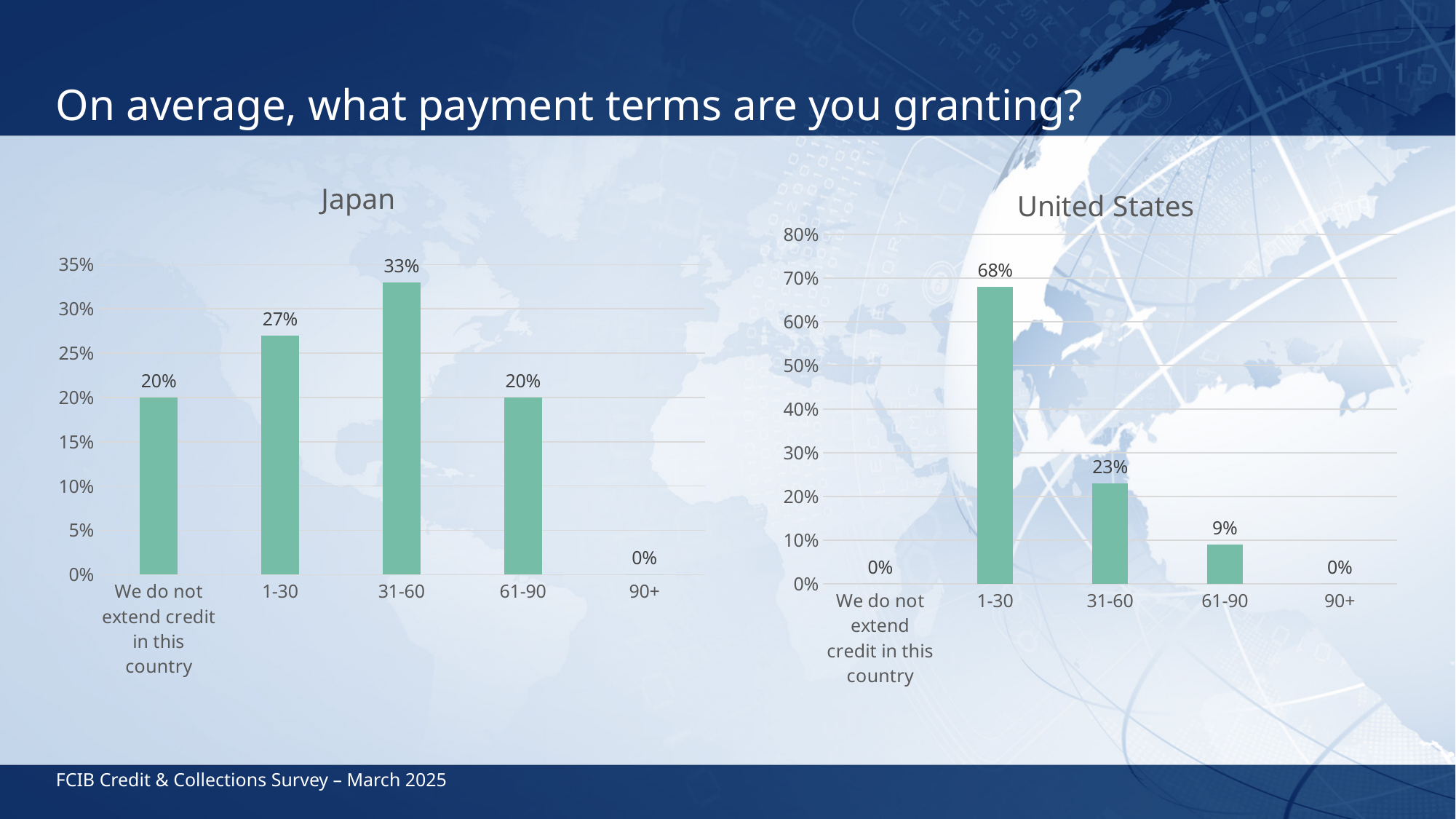
In the United States chart, what is the value for 'We do not extend credit in this country'? 0% In the Japan chart, which is larger, the value for 1-30 or the value for 61-90? 1-30 In the United States chart, what is the difference between the values for 1-30 and 31-60? 45% In the Japan chart, what is the value for 31-60? 33% How many categories are shown on the x axis of the United States chart? 5 In the United States chart, which category has the highest value? 1-30 In the United States chart, what is the value for 1-30? 68% In the Japan chart, what is the difference between the values for 31-60 and 61-90? 13% In the Japan chart, what is the value for 1-30? 27% In the United States chart, what is the value for 61-90? 9% What kind of chart is the Japan chart? Bar chart In the Japan chart, which category has the highest value? 31-60